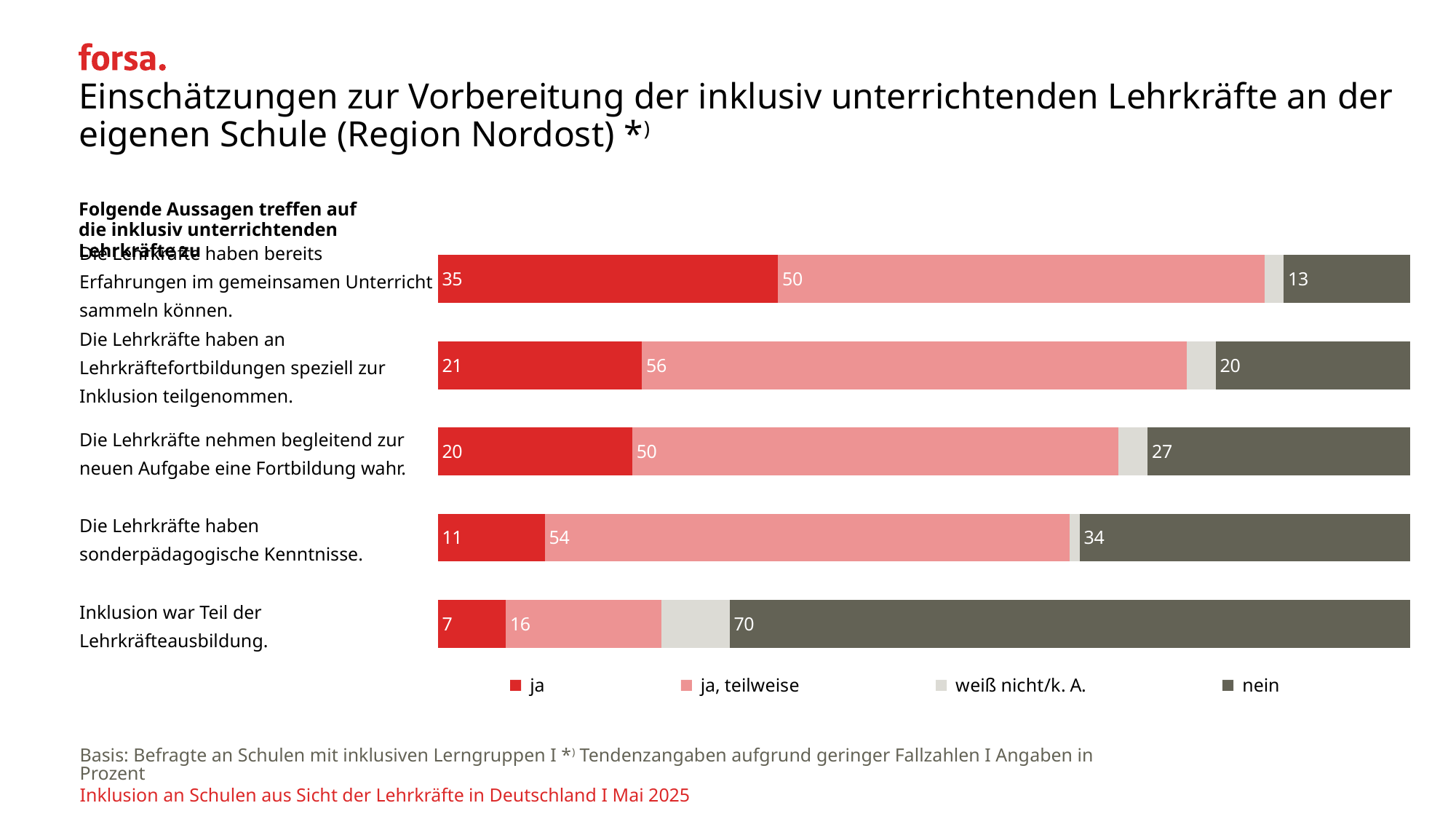
What is the difference between the 'nein' value for 'Inklusion war Teil der Lehrkräfteausbildung.' and the 'nein' value for 'Die Lehrkräfte haben sonderpädagogische Kenntnisse.'? 36 Which statement has the lowest 'nein' value? Die Lehrkräfte haben bereits Erfahrungen im gemeinsamen Unterricht sammeln können. What kind of chart is shown on the slide? stacked bar chart How many series does the legend list? 4 Which is larger: the 'ja' value for 'Die Lehrkräfte haben an Lehrkräftefortbildungen speziell zur Inklusion teilgenommen.' or the 'ja' value for 'Die Lehrkräfte haben sonderpädagogische Kenntnisse.'? Die Lehrkräfte haben an Lehrkräftefortbildungen speziell zur Inklusion teilgenommen. What is the 'ja' value for 'Die Lehrkräfte haben bereits Erfahrungen im gemeinsamen Unterricht sammeln können.'? 35 Which statement has the highest 'ja' value? Die Lehrkräfte haben bereits Erfahrungen im gemeinsamen Unterricht sammeln können. What is the 'ja, teilweise' value for 'Die Lehrkräfte haben an Lehrkräftefortbildungen speziell zur Inklusion teilgenommen.'? 56 How many statements (categories) are plotted in the chart? 5 Which legend entry is shown in dark grey? nein What is the 'ja, teilweise' value for 'Die Lehrkräfte nehmen begleitend zur neuen Aufgabe eine Fortbildung wahr.'? 50 What is the 'nein' value for 'Inklusion war Teil der Lehrkräfteausbildung.'? 70